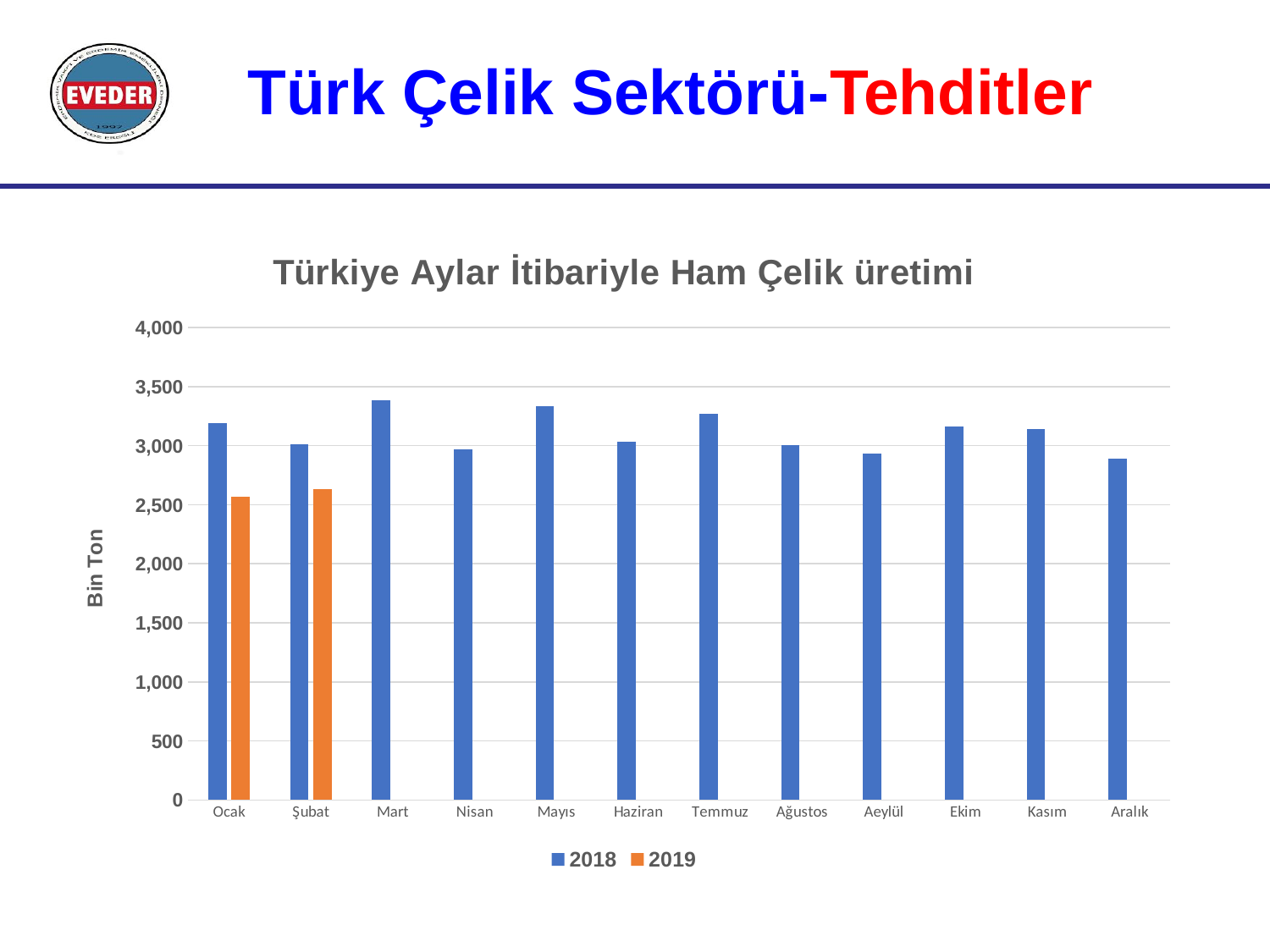
What kind of chart is shown on the slide? Bar chart Is the 2019 value for Ocak greater or less than 3,000? less What is the label on the vertical axis? Bin Ton Is the 2018 value for Aralık greater or less than 3,000? less How many series does the legend list? 2 How many months are shown on the x axis? 12 For Ocak, which series has the larger value, 2018 or 2019? 2018 Is the 2019 value for Şubat greater or less than 2,500? greater What is the title of the chart? Türkiye Aylar İtibariyle Ham Çelik üretimi Which 2018 value is larger, Mart or Aralık? Mart Which 2019 value is larger, Ocak or Şubat? Şubat